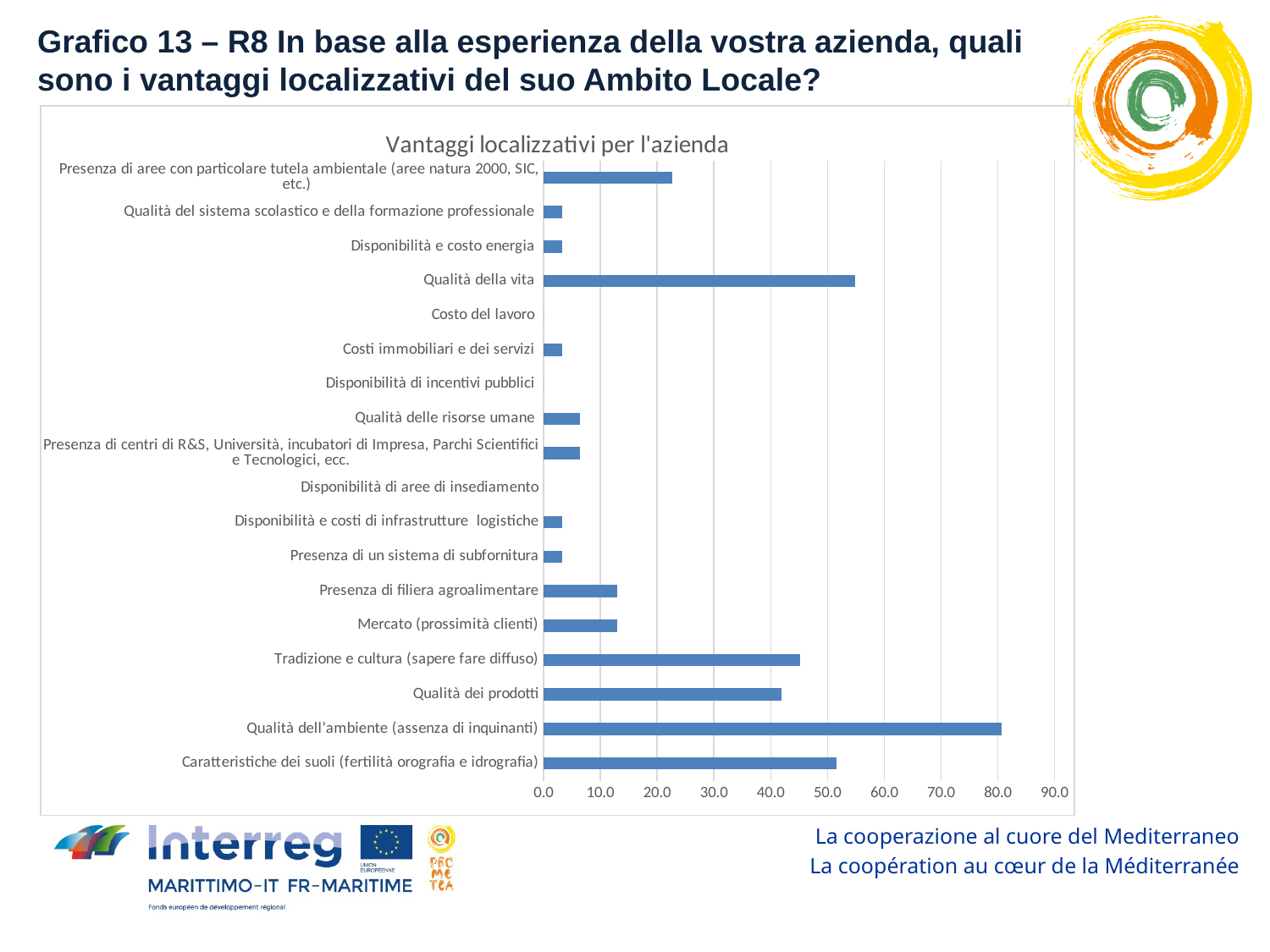
What is the title of the chart? Vantaggi localizzativi per l'azienda Is the value for Qualità dell'ambiente (assenza di inquinanti) greater or less than 70.0? greater Is the value for Tradizione e cultura (sapere fare diffuso) greater or less than 50.0? less Which category has the highest value? Qualità dell'ambiente (assenza di inquinanti) What kind of chart is shown on the slide? bar chart How many categories show no visible bar in the chart? 3 How many categories are plotted in the chart? 18 Which is larger, the value for Caratteristiche dei suoli (fertilità orografia e idrografia) or the value for Qualità dei prodotti? Caratteristiche dei suoli (fertilità orografia e idrografia) Is the value for Presenza di aree con particolare tutela ambientale (aree natura 2000, SIC, etc.) greater or less than 30.0? less Which is larger, the value for Qualità della vita or the value for Tradizione e cultura (sapere fare diffuso)? Qualità della vita